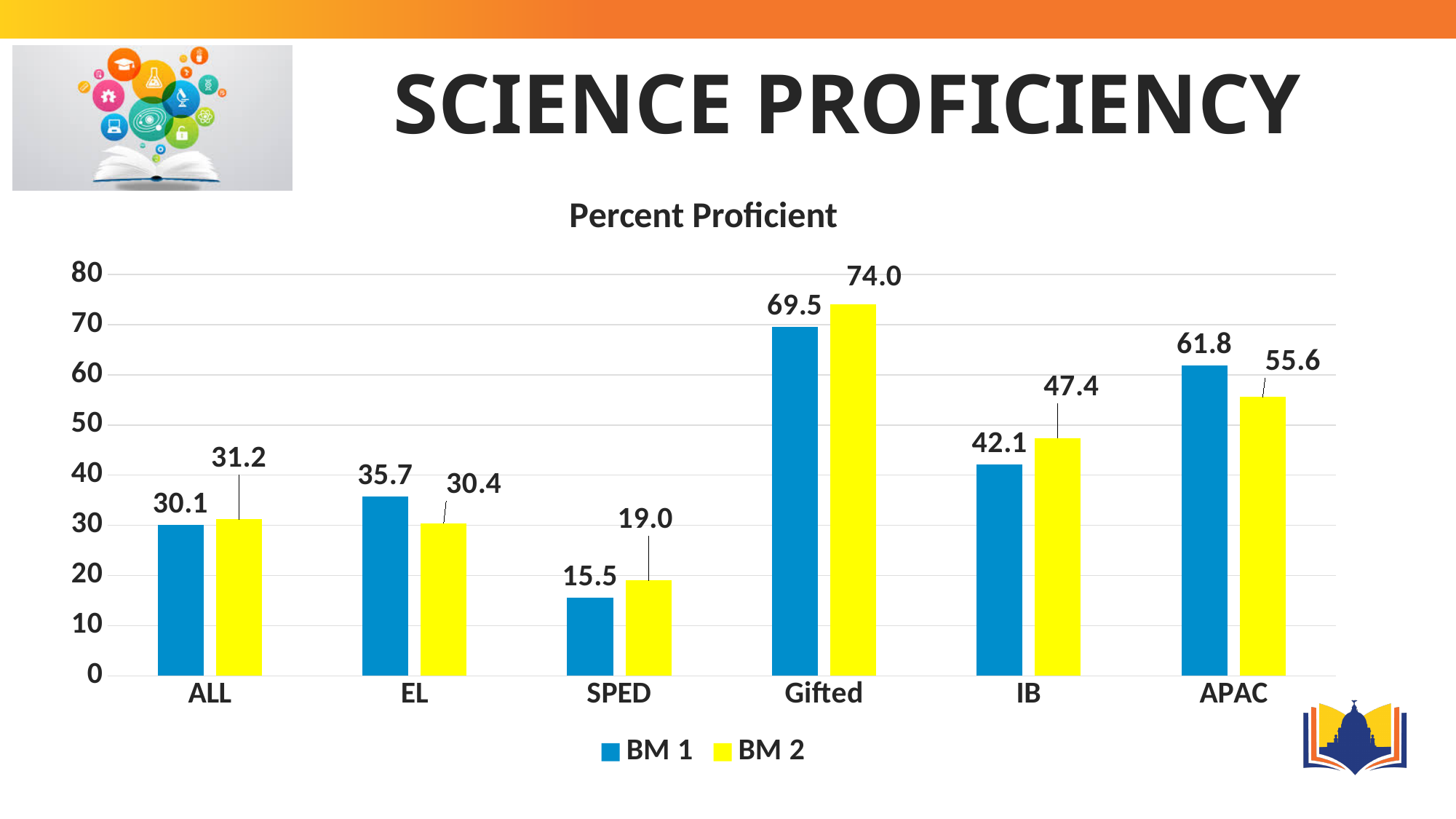
What kind of chart is shown on the slide? Bar chart What is the BM 2 value for SPED? 19.0 Which category has the lowest BM 1 value? SPED What is the BM 2 value for APAC? 55.6 What is the title of the chart? Percent Proficient Is the BM 1 value for APAC greater or less than 60? greater How many categories are shown on the x axis? 6 What is the BM 1 value for Gifted? 69.5 Which category has the highest BM 2 value? Gifted Which is larger for EL, the BM 1 value or the BM 2 value? BM 1 How many series does the legend list? 2 What is the difference between the BM 2 and BM 1 values for IB? 5.3